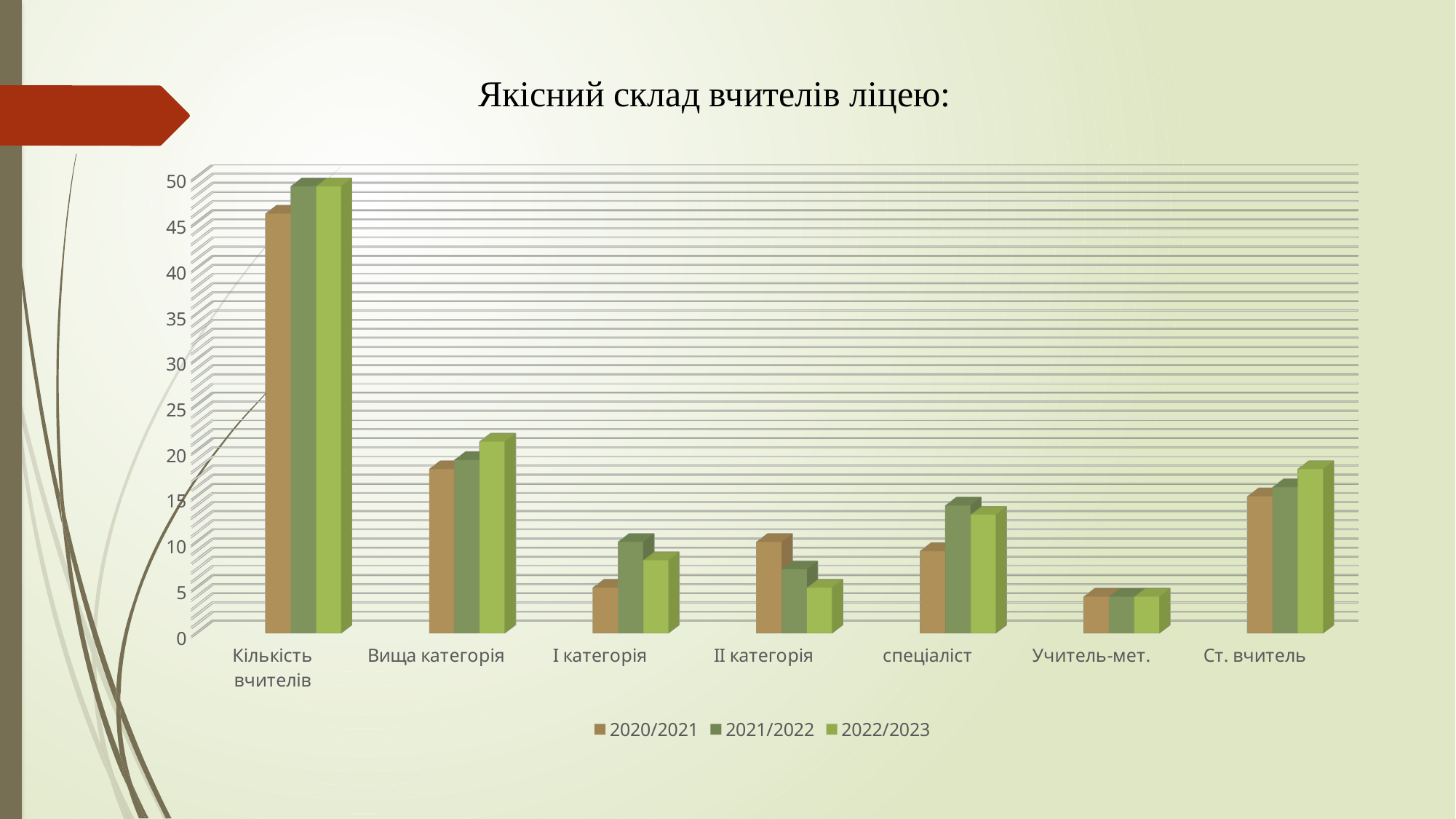
What is the title of the chart? Якісний склад вчителів ліцею: Is the value for Учитель-мет. in 2022/2023 greater or less than 10? less For II категорія, which series has the larger value: 2020/2021 or 2022/2023? 2020/2021 Is the value for I категорія in 2020/2021 greater or less than 10? less Is the value for Кількість вчителів in 2020/2021 greater or less than 40? greater How many series does the legend list? 3 Which category has the lowest value for the 2021/2022 series? Учитель-мет. Which category has the highest value for the 2020/2021 series? Кількість вчителів What kind of chart is shown on the slide? bar chart How many categories are shown on the x axis? 7 For I категорія, which series has the larger value: 2020/2021 or 2021/2022? 2021/2022